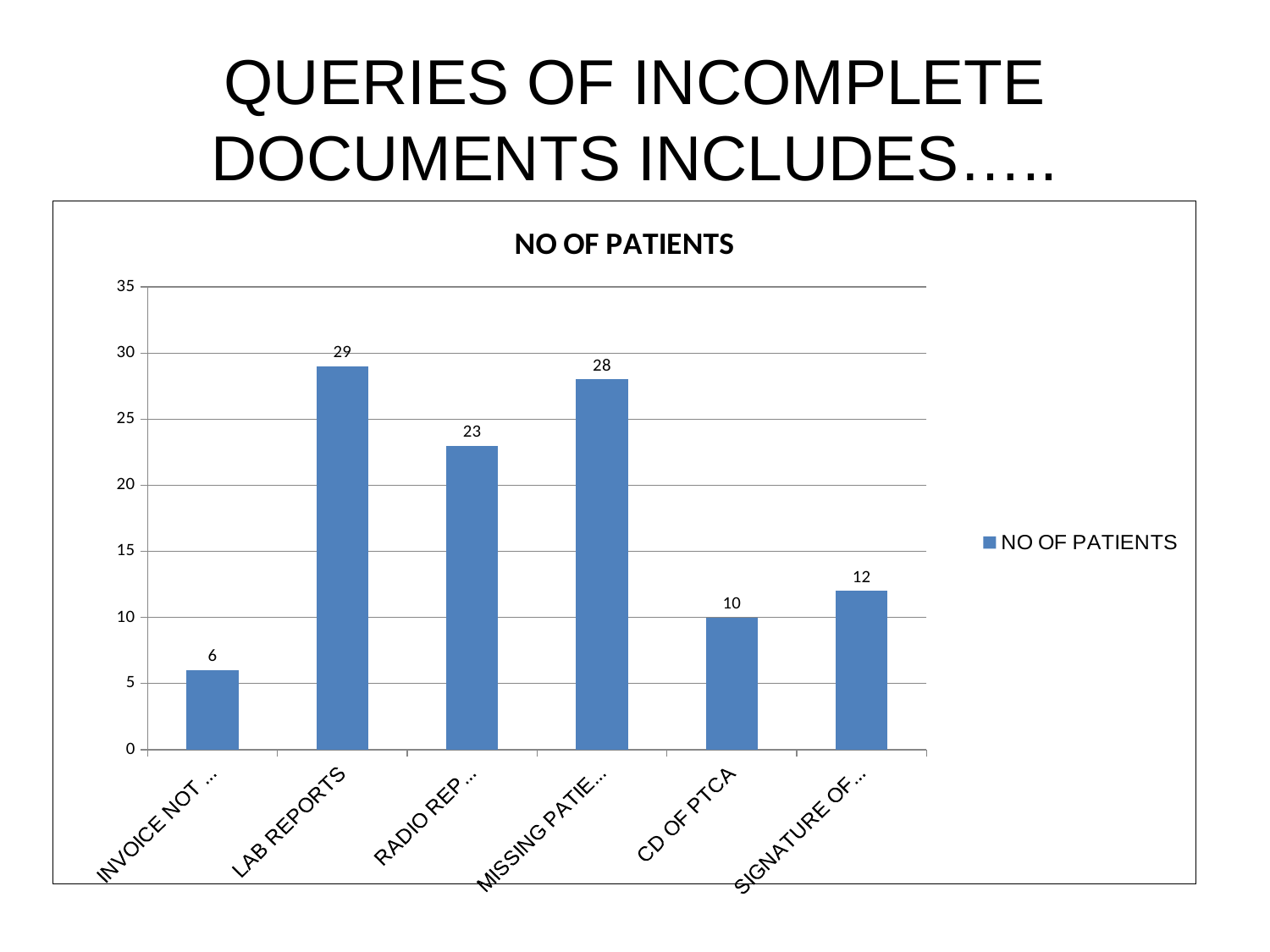
What type of chart is shown on the slide? bar chart What is the lowest value shown on any bar in the chart? 6 Which category has the highest number of patients? LAB REPORTS How many bars are plotted in the chart? 6 Is the value for CD OF PTCA greater or less than 15? less What is the highest value shown on the vertical axis? 35 What is the difference between the values for LAB REPORTS and CD OF PTCA? 19 What is the number of patients for CD OF PTCA? 10 How many series does the legend list? 1 Which is larger, the value for LAB REPORTS or the value for CD OF PTCA? LAB REPORTS What is the number of patients for LAB REPORTS? 29 What is the title of the chart? NO OF PATIENTS